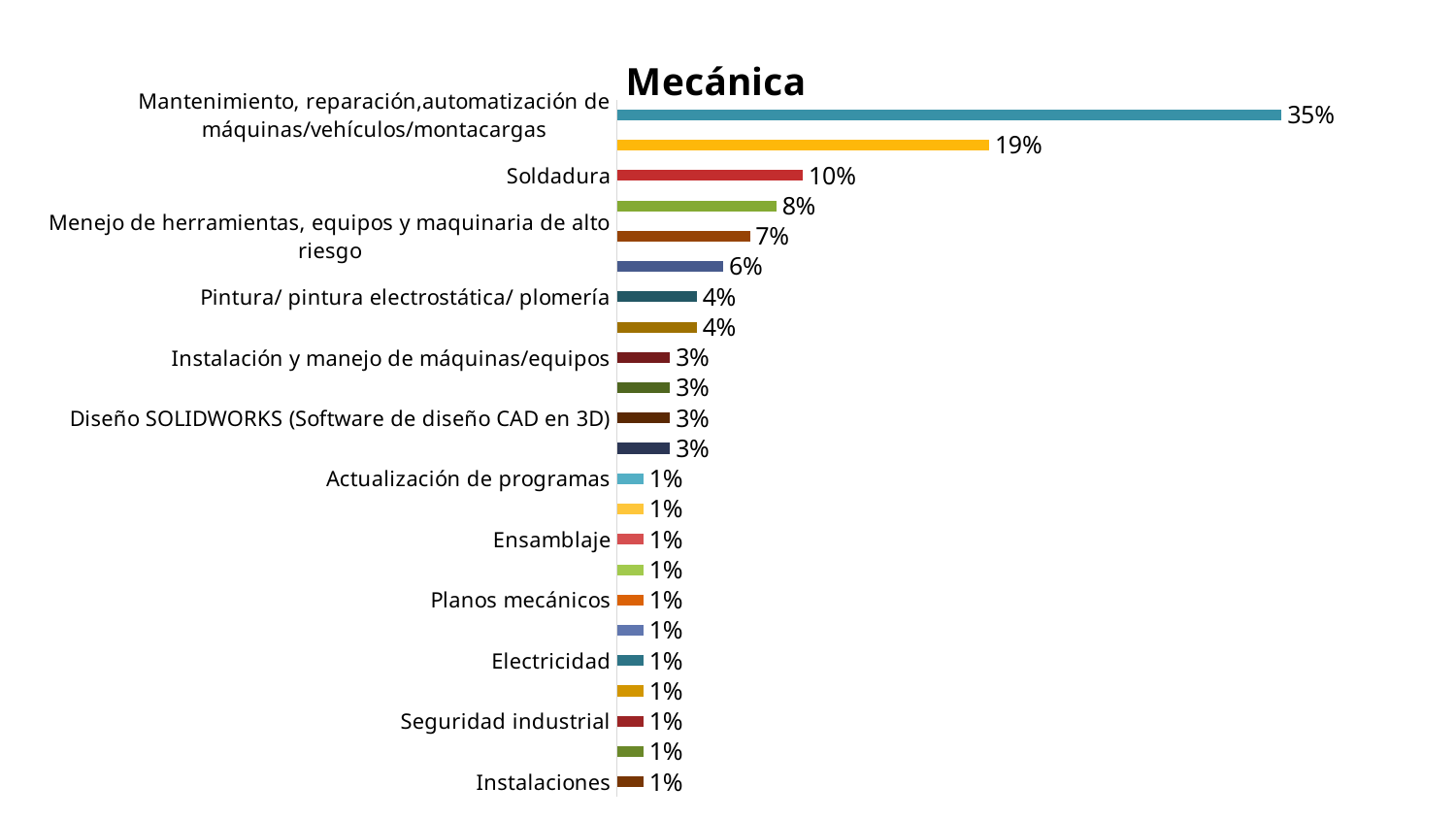
What is the value for Pintura/ pintura electrostática/ plomería? 4% Which is larger, the value for Soldadura or the value for Pintura/ pintura electrostática/ plomería? Soldadura How many bars are plotted in the chart? 23 What type of chart is shown on the slide? bar chart What is the value for Electricidad? 1% What is the difference between the values for Mantenimiento, reparación, automatización de máquinas/vehículos/montacargas and Soldadura? 25% What is the value for Diseño SOLIDWORKS (Software de diseño CAD en 3D)? 3% What is the title of the chart? Mecánica What is the value for Mantenimiento, reparación, automatización de máquinas/vehículos/montacargas? 35% Which category has the highest value? Mantenimiento, reparación, automatización de máquinas/vehículos/montacargas What is the value for Menejo de herramientas, equipos y maquinaria de alto riesgo? 7% What is the value for Soldadura? 10%